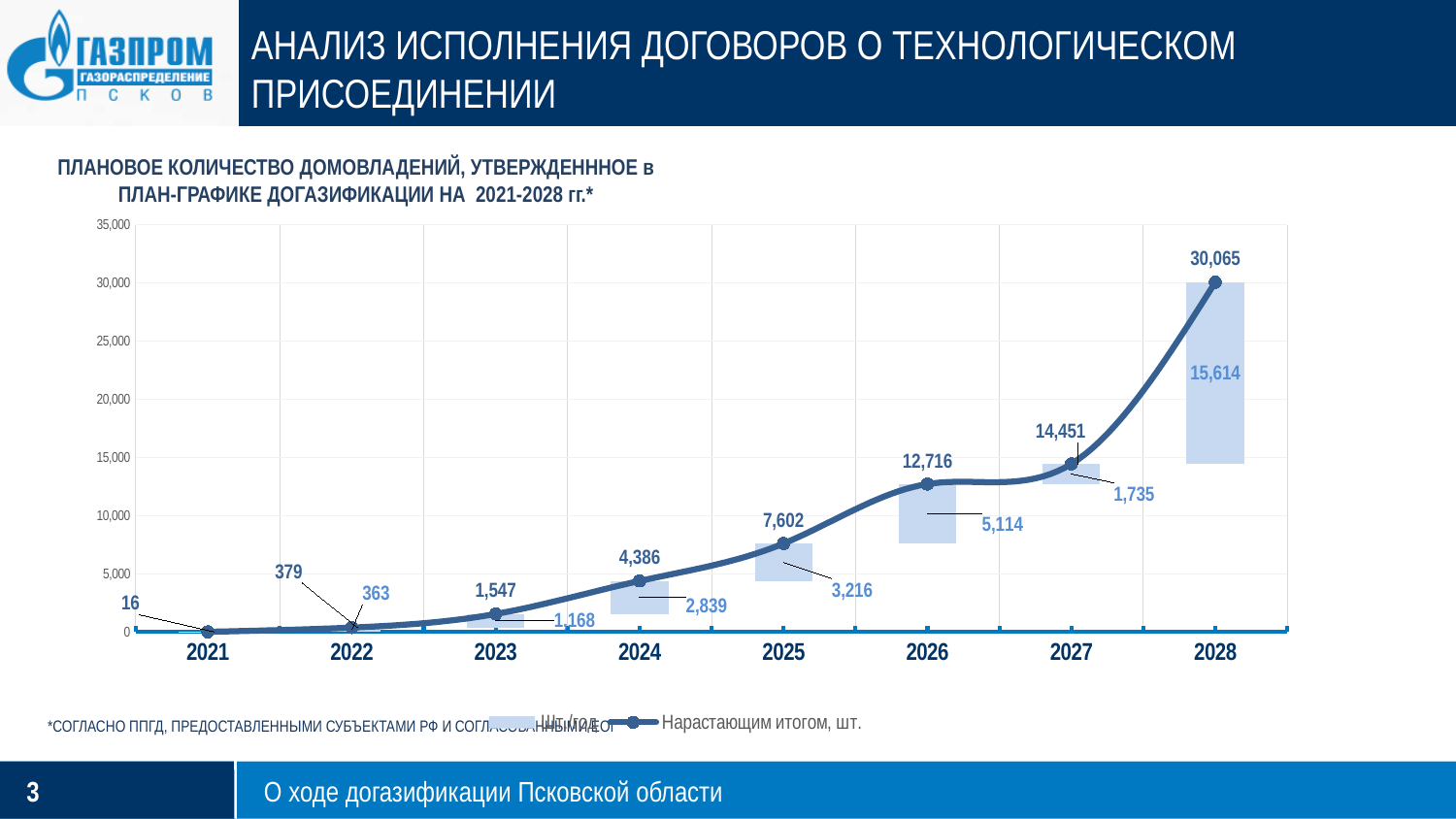
Is the cumulative value for 2026 greater or less than 10,000? greater What is the cumulative value (Нарастающим итогом) for 2025? 7,602 Which year has the highest annual value (Шт./год bar)? 2028 How many series does the legend list? 2 Does the cumulative line rise or fall from 2021 to 2028? rise Which year has the lowest cumulative value (Нарастающим итогом)? 2021 What is the cumulative value (Нарастающим итогом) for 2028? 30,065 What is the difference between the cumulative values for 2028 and 2027? 15,614 Which is larger, the annual value for 2025 or the annual value for 2027? 2025 What is the annual value (Шт./год bar) for 2026? 5,114 How many years are shown on the x axis? 8 What is the annual value (Шт./год bar) for 2023? 1,168